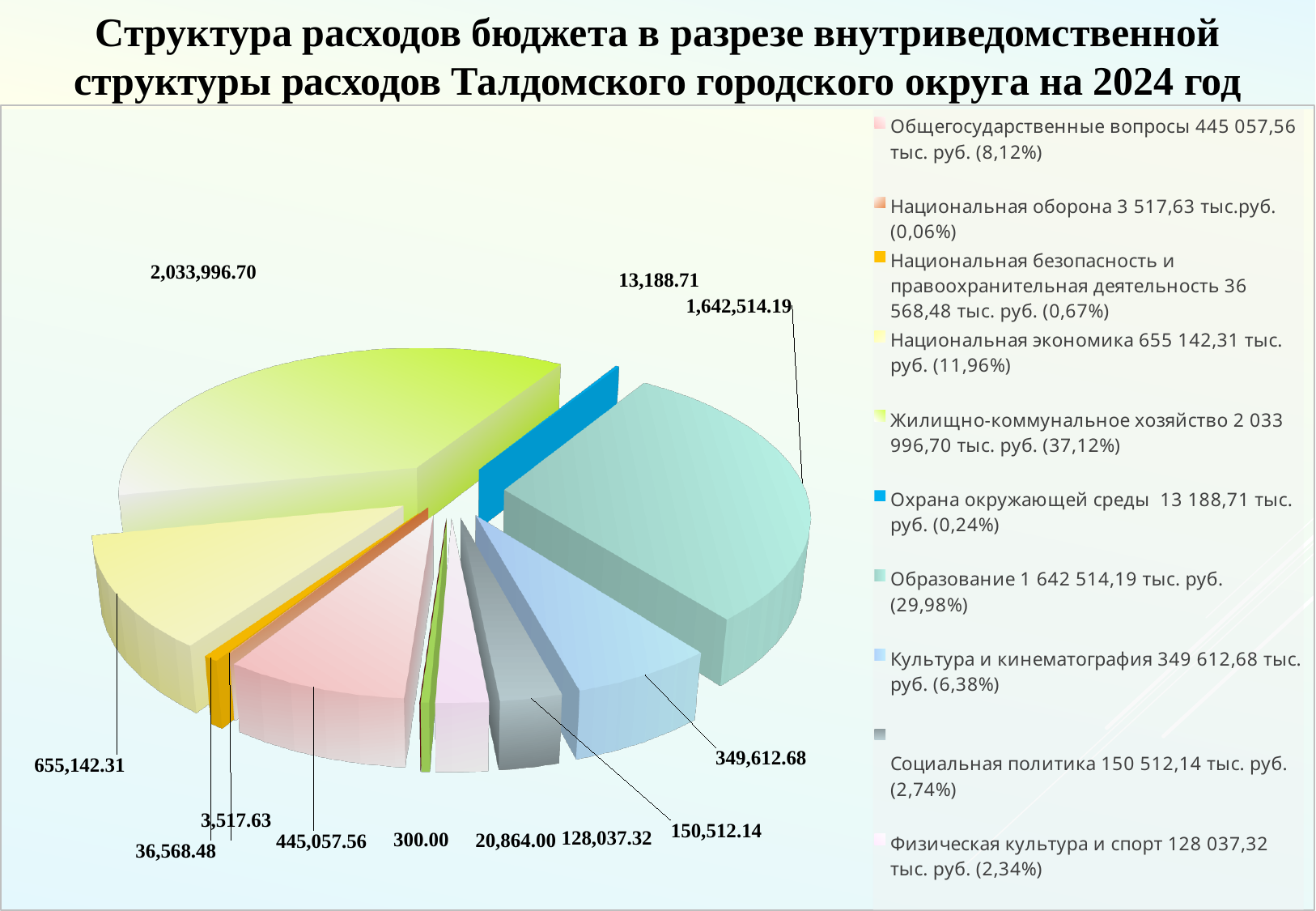
What is the difference between the values for Жилищно-коммунальное хозяйство and Образование? 391,482.51 Which category has the largest share of the budget expenditure? Жилищно-коммунальное хозяйство What percentage share does Жилищно-коммунальное хозяйство have according to the legend? 37,12% What is the smallest value printed as a data label on the chart? 300.00 What is the value shown for Образование? 1,642,514.19 Which is larger, the value for Социальная политика or the value for Физическая культура и спорт? Социальная политика What percentage share does Образование have according to the legend? 29,98% How many entries does the legend list? 10 What is the difference between the values for Национальная экономика and Общегосударственные вопросы? 210,084.75 What type of chart is shown on the slide? Pie chart What is the value shown for Национальная экономика? 655,142.31 What is the value shown for Культура и кинематография? 349,612.68